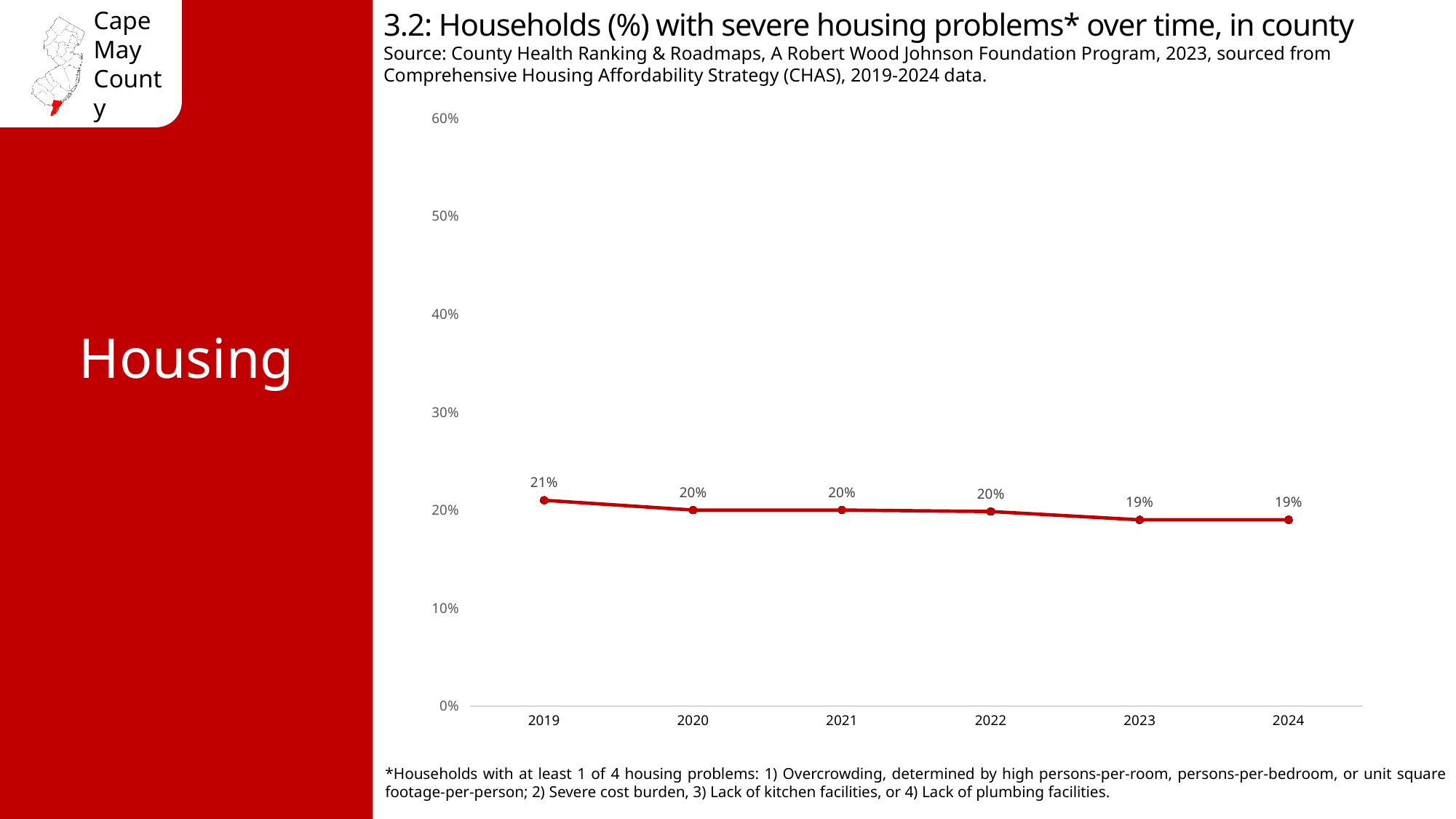
What is the highest value shown on the vertical axis? 60% What is the difference between the 2019 value and the 2024 value? 2% Which is larger, the value for 2019 or the value for 2023? 2019 What is the value shown for 2022? 20% How many years are plotted on the chart? 6 Do the values rise or fall from 2019 to 2024? fall What percentage of households had severe housing problems in 2019? 21% What percentage of households had severe housing problems in 2024? 19% What kind of chart is shown on the slide? line chart What is the title of the chart? 3.2: Households (%) with severe housing problems* over time, in county Which year has the highest percentage of households with severe housing problems? 2019 Is the value for 2021 greater or less than 30%? less